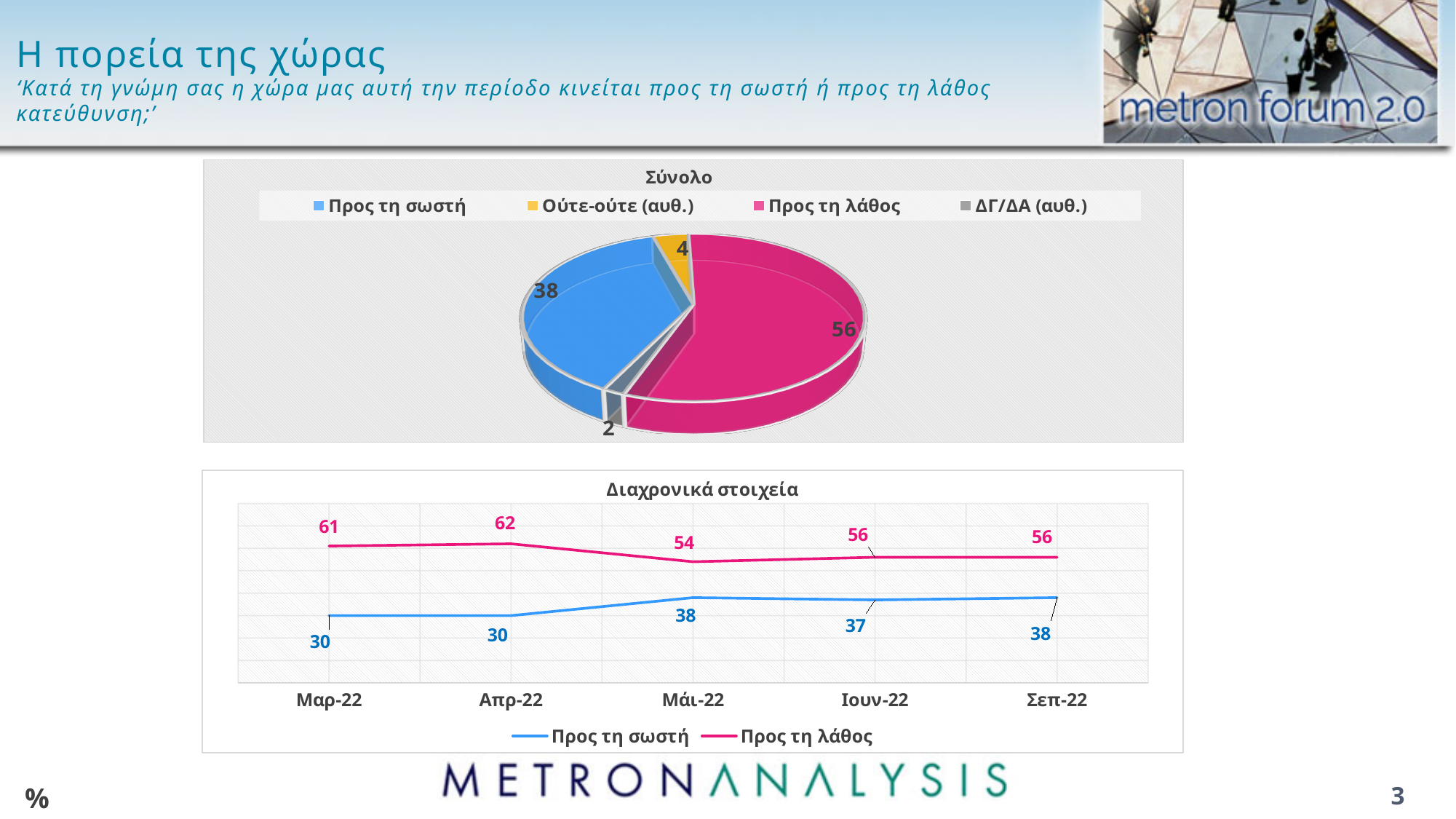
In the 'Σύνολο' pie chart, which category has the largest slice? Προς τη λάθος In the 'Σύνολο' pie chart, what is the value for 'Προς τη λάθος'? 56 In the 'Διαχρονικά στοιχεία' chart, how many series does the legend list? 2 In the 'Σύνολο' pie chart, how many categories does the legend list? 4 What kind of chart is 'Διαχρονικά στοιχεία'? Line chart In the 'Διαχρονικά στοιχεία' chart, what is the value of 'Προς τη σωστή' for Μάι-22? 38 In the 'Διαχρονικά στοιχεία' chart, what is the difference between 'Προς τη λάθος' and 'Προς τη σωστή' in Μαρ-22? 31 In the 'Διαχρονικά στοιχεία' chart, in which month does 'Προς τη λάθος' reach its highest value? Απρ-22 In the 'Σύνολο' pie chart, what is the value for 'Προς τη σωστή'? 38 In the 'Σύνολο' pie chart, which category has the smallest slice? ΔΓ/ΔΑ (αυθ.) In the 'Σύνολο' pie chart, what is the difference between 'Προς τη λάθος' and 'Προς τη σωστή'? 18 In the 'Διαχρονικά στοιχεία' chart, what is the value of 'Προς τη λάθος' for Απρ-22? 62